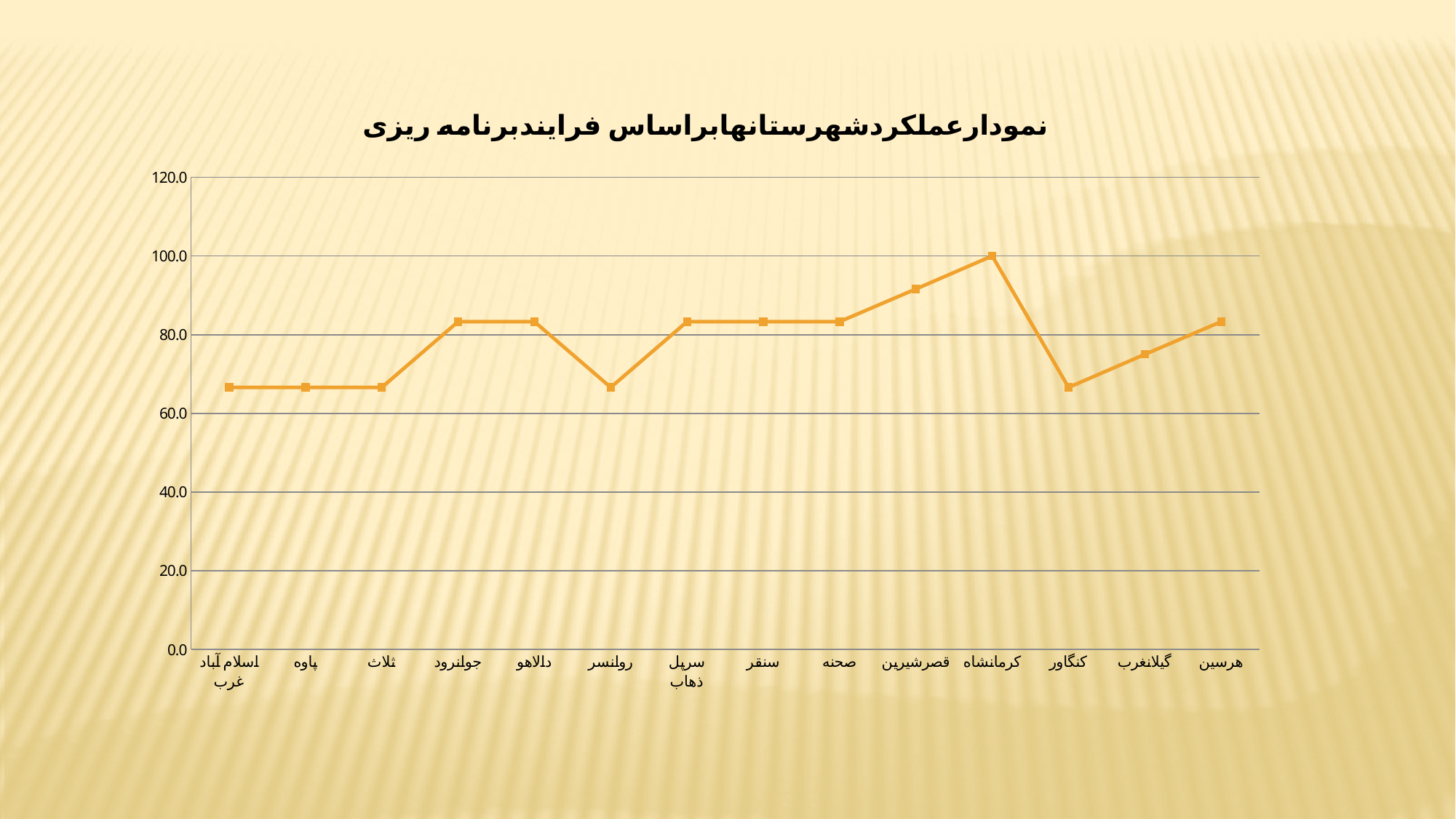
How many categories (cities) are plotted along the x axis? 14 Which has the larger value, کرمانشاه or کنگاور? کرمانشاه Is the value for جوانرود greater or less than 80.0? greater What is the title of the chart? نمودارعملکردشهرستانهابراساس فرایندبرنامه ریزی Is the value for کنگاور greater or less than 80.0? less Is the value for قصرشیرین greater or less than 80.0? greater Which has the larger value, قصرشیرین or صحنه? قصرشیرین Which category has the highest value? کرمانشاه What is the value for کرمانشاه? 100.0 What kind of chart is shown on the slide? line chart Does the line rise or fall from کرمانشاه to کنگاور? fall